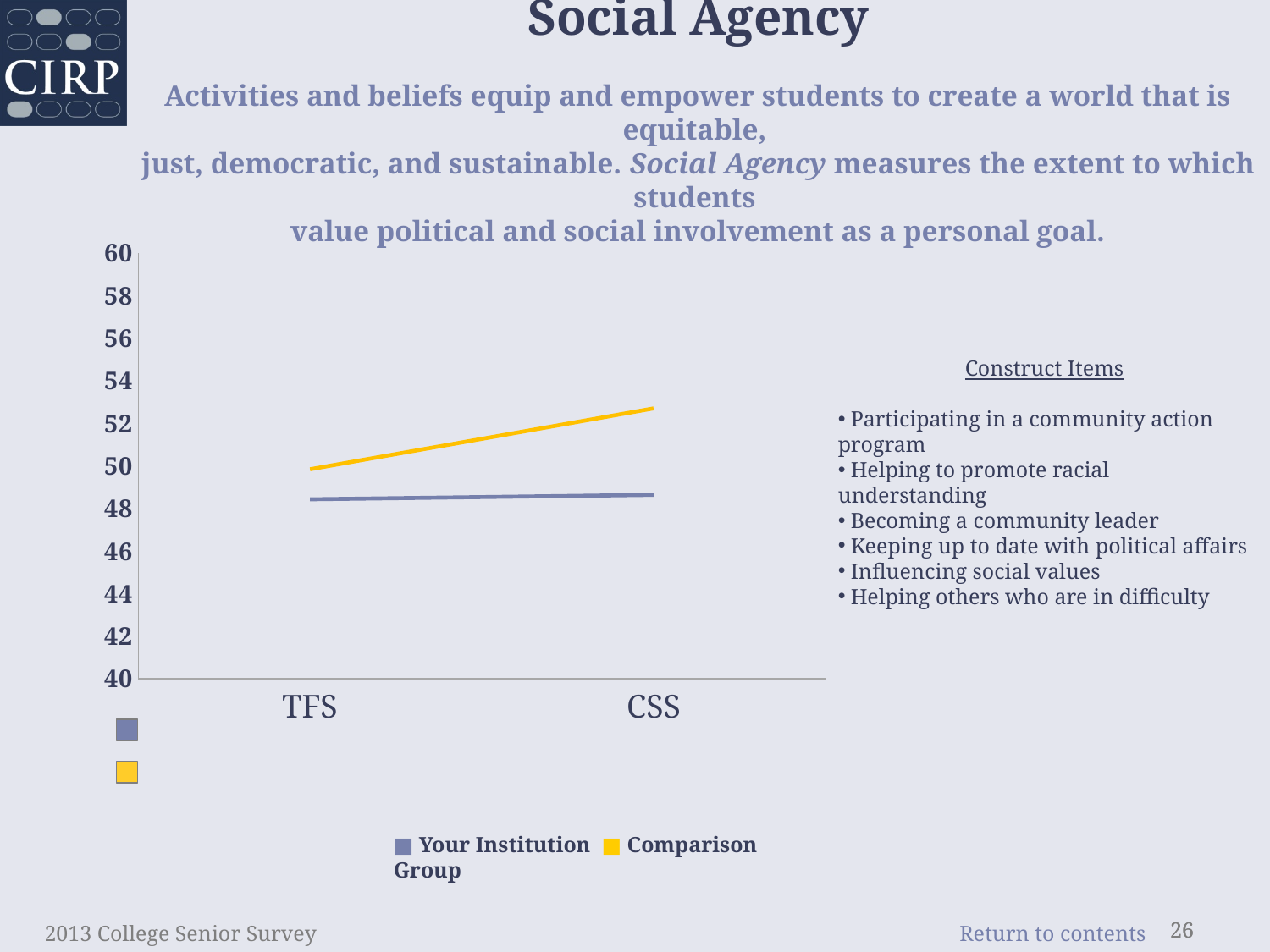
Is the value for Comparison Group at CSS greater or less than 54? less Which series is shown in yellow in the chart legend? Comparison Group How many series does the chart legend list? 2 Which series has the higher value at CSS, Your Institution or Comparison Group? Comparison Group Does the Comparison Group line rise or fall from TFS to CSS? rise Is the value for Comparison Group at CSS greater or less than 52? greater What kind of chart is shown on the slide? line chart Is the value for Your Institution at TFS greater or less than 48? greater How many categories are shown on the x axis of the chart? 2 What is the title of the chart on the slide? Social Agency Which series has the higher value at TFS, Your Institution or Comparison Group? Comparison Group